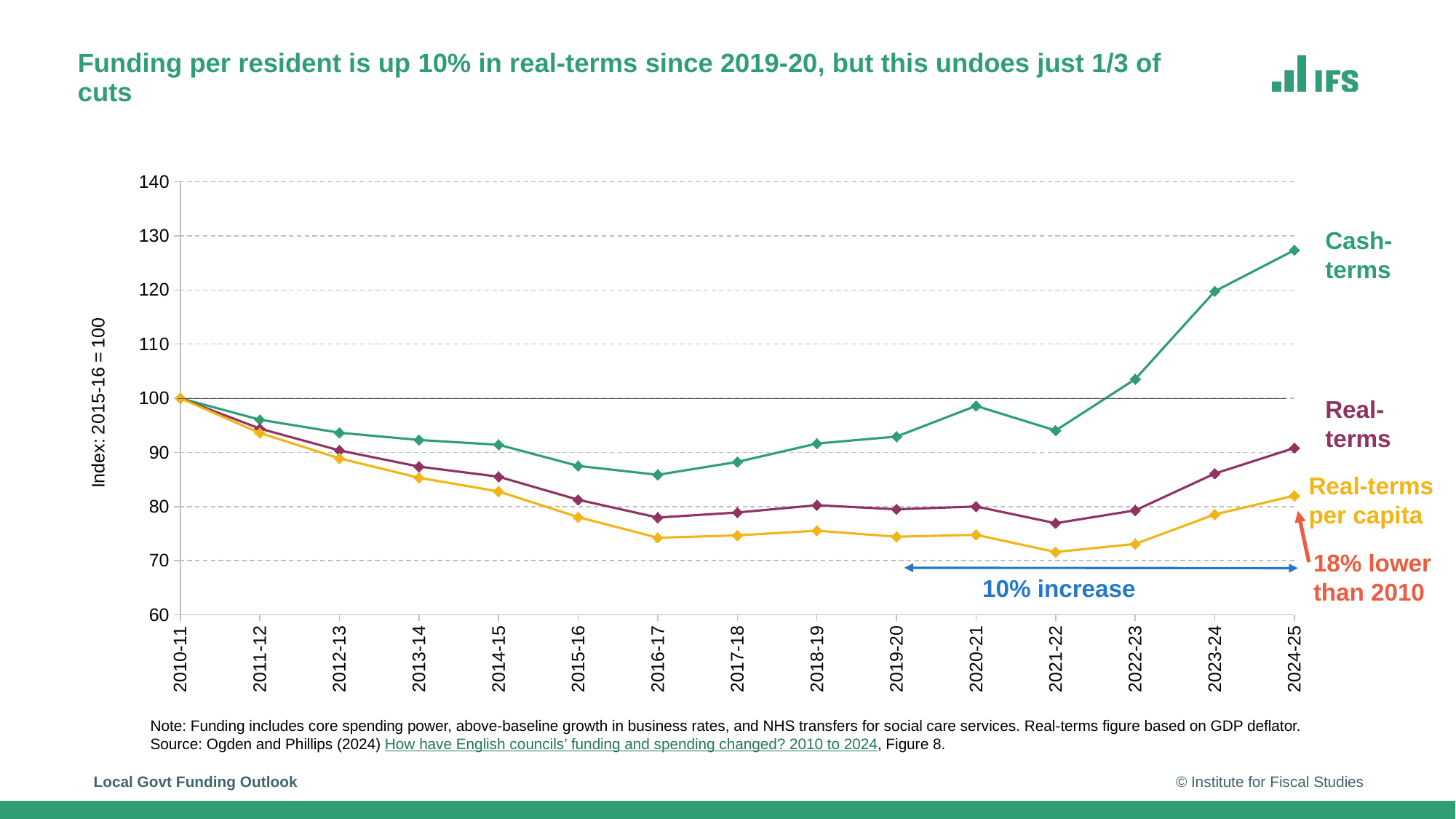
Is the Cash-terms value for 2022-23 greater or less than 100? greater What is the index value of the Cash-terms series in 2010-11? 100 In which year does the Real-terms per capita series reach its lowest point? 2021-22 Is the Cash-terms value for 2024-25 greater or less than 120? greater Which series has the lowest value in 2024-25? Real-terms per capita How many years are shown along the x axis of the chart? 15 What type of chart is shown on the slide? line chart For the Cash-terms series, which year has the larger value: 2020-21 or 2021-22? 2020-21 Is the Real-terms per capita value for 2016-17 greater or less than 80? less Does the Real-terms per capita series rise or fall between 2010-11 and 2016-17? fall How many series are plotted on the chart? 3 Which series has the highest value in 2024-25? Cash-terms